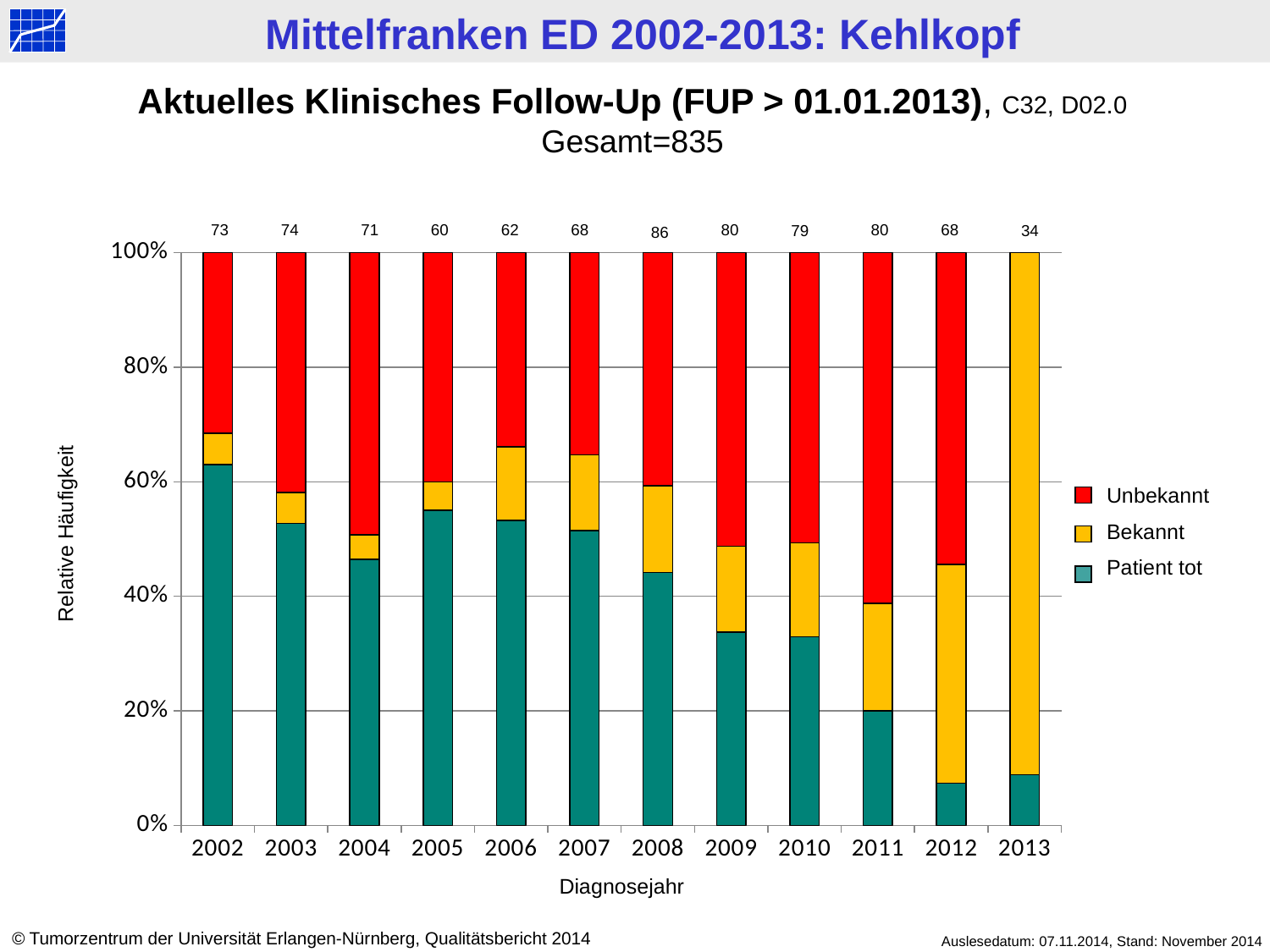
How many diagnosis years are shown on the x axis? 12 What number is printed above the bar for 2005? 60 Which year has the larger number printed above its bar, 2002 or 2003? 2003 What number is printed above the bar for 2013? 34 What number is printed above the bar for 2008? 86 What kind of chart is shown on the slide? Stacked bar chart Is the 'Patient tot' share for 2002 greater or less than 60%? greater Which diagnosis year has the lowest number printed above its bar? 2013 Which diagnosis year has the highest number printed above its bar? 2008 How many series does the legend list? 3 Is the 'Patient tot' share for 2012 greater or less than 20%? less What is the difference between the numbers printed above the bars for 2008 and 2013? 52